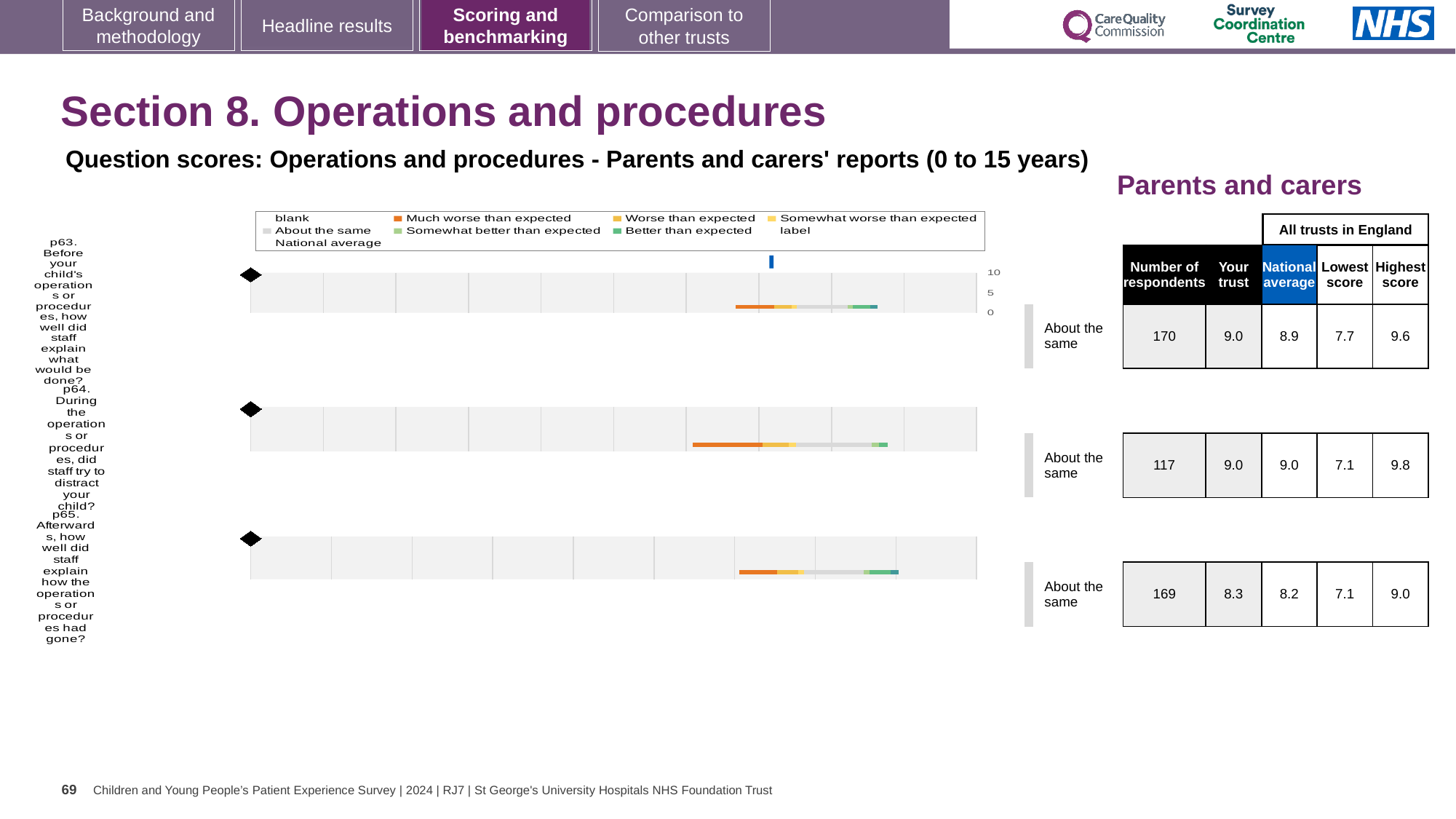
How many questions (p63, p64, p65) are plotted on the slide? 3 Which colour does the legend use for 'Much worse than expected'? orange What is the 'Your trust' score for p63 (Before your child's operations or procedures, how well did staff explain what would be done?)? 9.0 Which question has the highest 'Highest score' across all trusts in England? p64 How many entries does the chart legend list? 9 Which question has the lowest 'Your trust' score? p65 For p63, which is larger: the 'Your trust' score or the national average? Your trust What benchmark category is shown for p64? About the same What is the national average score for p65 (Afterwards, how well did staff explain how the operations or procedures had gone?)? 8.2 For p65, what is the difference between the highest score and the lowest score across all trusts in England? 1.9 How many respondents answered p64 (During the operations or procedures, did staff try to distract your child?)? 117 What kind of chart is used to show the question scores on this slide? bar chart